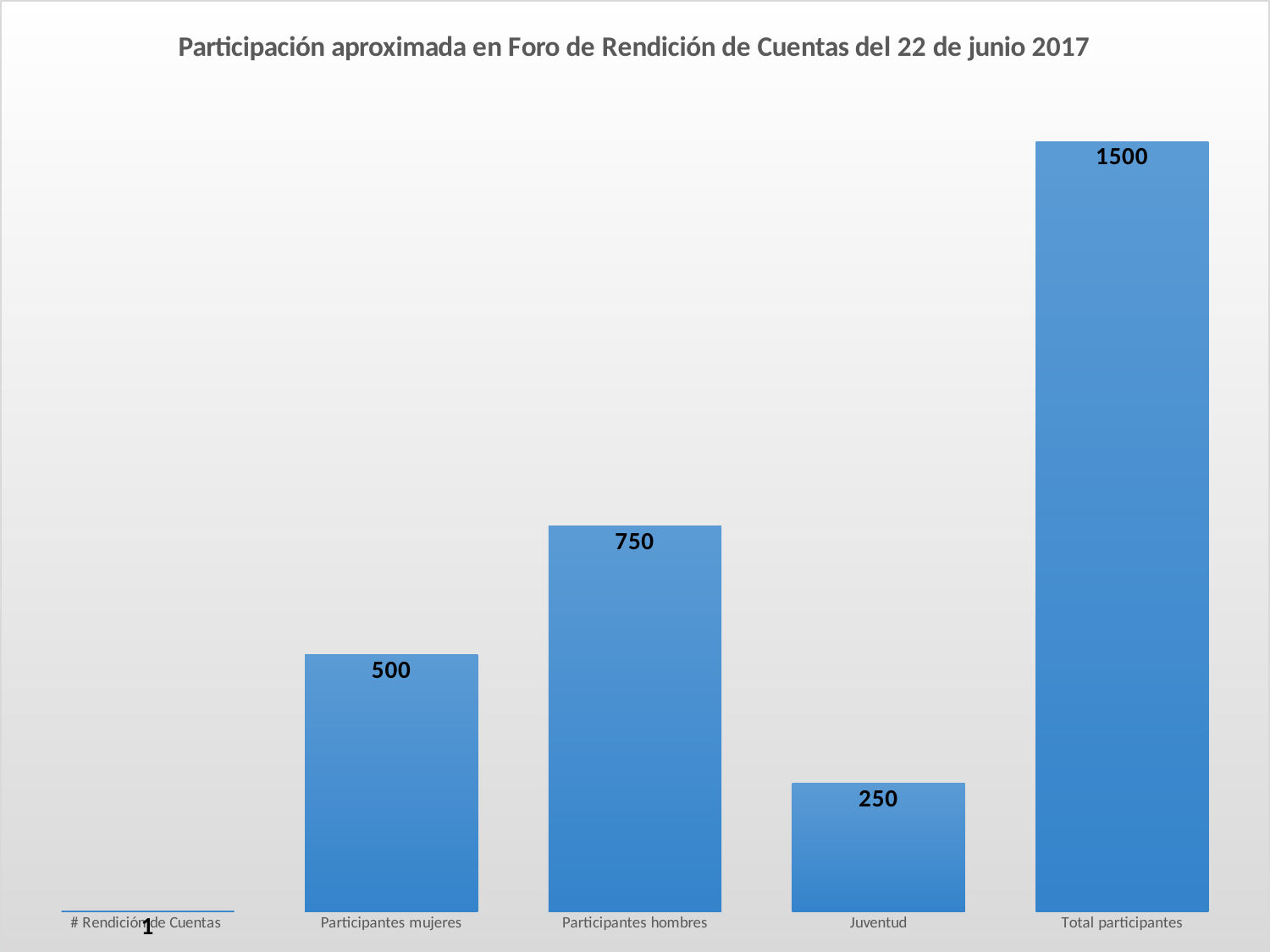
What is the value for Participantes mujeres? 500 Which category has the highest value? Total participantes How many categories are shown on the x axis? 5 What is the title of the chart? Participación aproximada en Foro de Rendición de Cuentas del 22 de junio 2017 What kind of chart is this? Bar chart What is the value for # Rendición de Cuentas? 1 What is the value for Total participantes? 1500 What is the value for Juventud? 250 What is the difference between Participantes hombres and Participantes mujeres? 250 Which category has the lowest value? # Rendición de Cuentas What is the value for Participantes hombres? 750 Which is larger, Participantes mujeres or Juventud? Participantes mujeres